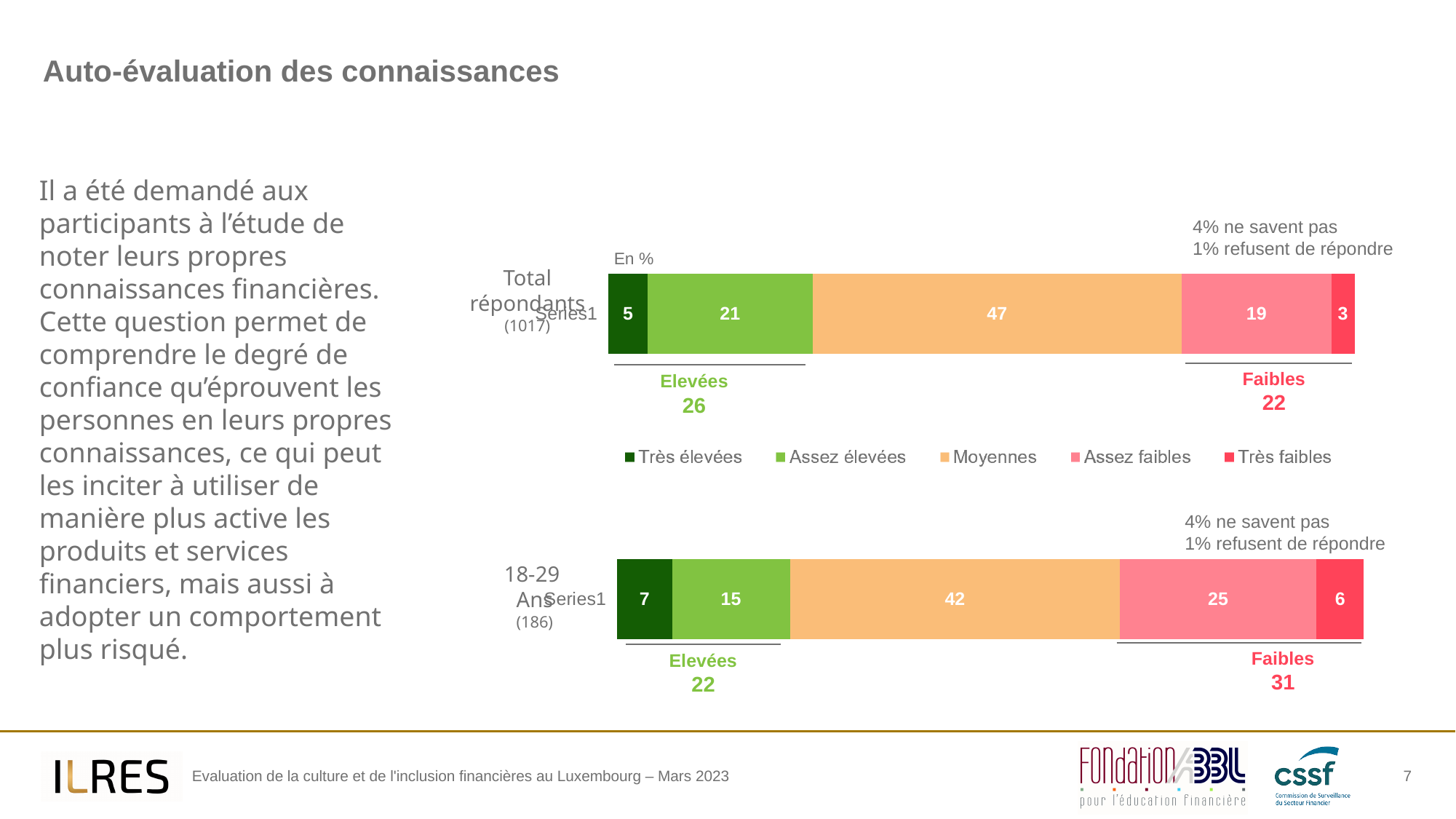
How many series does the legend list? 5 In the top chart (Total répondants), which category has the lowest value? Très faibles In the top chart (Total répondants), what is the total of the stacked bar's printed segment values? 95 In the top chart (Total répondants), what is the value for Très élevées? 5 What kind of chart is shown on the slide? Stacked bar chart In the bottom chart (18-29 Ans), what is the difference between Moyennes and Assez faibles? 17 In the bottom chart (18-29 Ans), what is the value for Assez faibles? 25 Is the value for Assez élevées larger in the top chart (Total répondants) or in the bottom chart (18-29 Ans)? Top chart (Total répondants) In the top chart (Total répondants), what is the value for Moyennes? 47 In the bottom chart (18-29 Ans), which category has the highest value? Moyennes What colour represents Moyennes in the legend? Orange In the bottom chart (18-29 Ans), what is the difference between Très élevées and Très faibles? 1